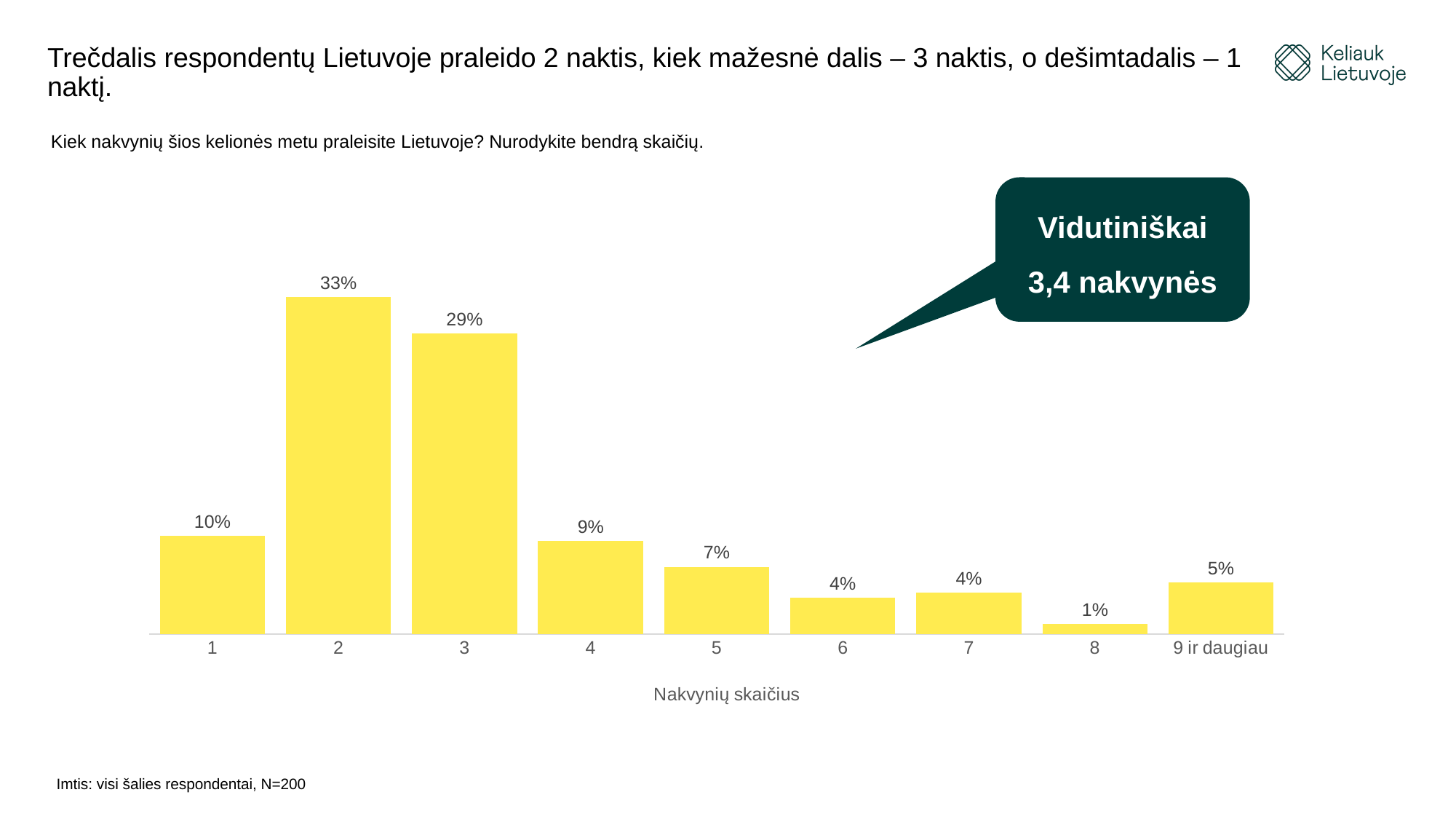
Which number of nights has the highest share of respondents? 2 Which is larger, the value for 1 night or the value for 5 nights? 1 night How many categories are shown on the x axis? 9 What is the difference between the values for 2 nights and 3 nights? 4% Which category has the lowest value? 8 What is the difference between the values for 1 night and 4 nights? 1% What percentage of respondents spent 2 nights in Lithuania? 33% What average number of nights is stated in the callout on the slide? 3,4 nakvynės What type of chart is shown on the slide? Bar chart What percentage of respondents spent 5 nights? 7% What is the x-axis title of the chart? Nakvynių skaičius What is the value for the category '9 ir daugiau'? 5%